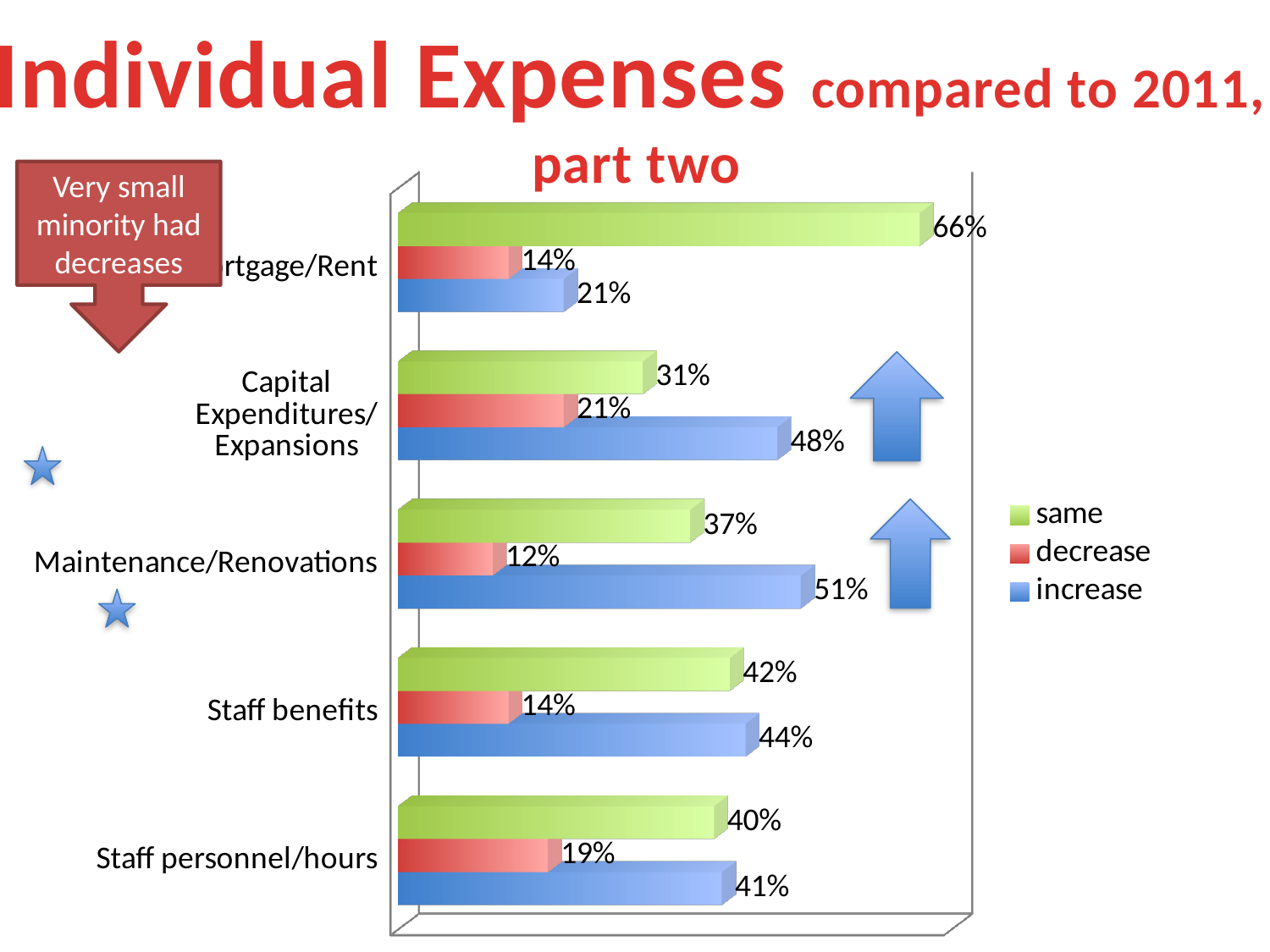
Which colour represents the 'increase' series in the legend? Blue How many expense categories are shown on the chart? 5 What is the value of the decrease bar for Capital Expenditures/Expansions? 21% Which category has the lowest 'decrease' value? Maintenance/Renovations How many series does the legend list? 3 What type of chart is shown on the slide? Bar chart For Staff personnel/hours, which is larger: the 'same' value or the 'decrease' value? same What percentage reported Staff benefits expenses stayed the same? 42% What percentage of respondents reported an increase in Maintenance/Renovations expenses? 51% Which category has the highest 'same' value? Mortgage/Rent What percentage reported an increase in Staff personnel/hours? 41% What is the difference between the increase and decrease values for Capital Expenditures/Expansions? 27%